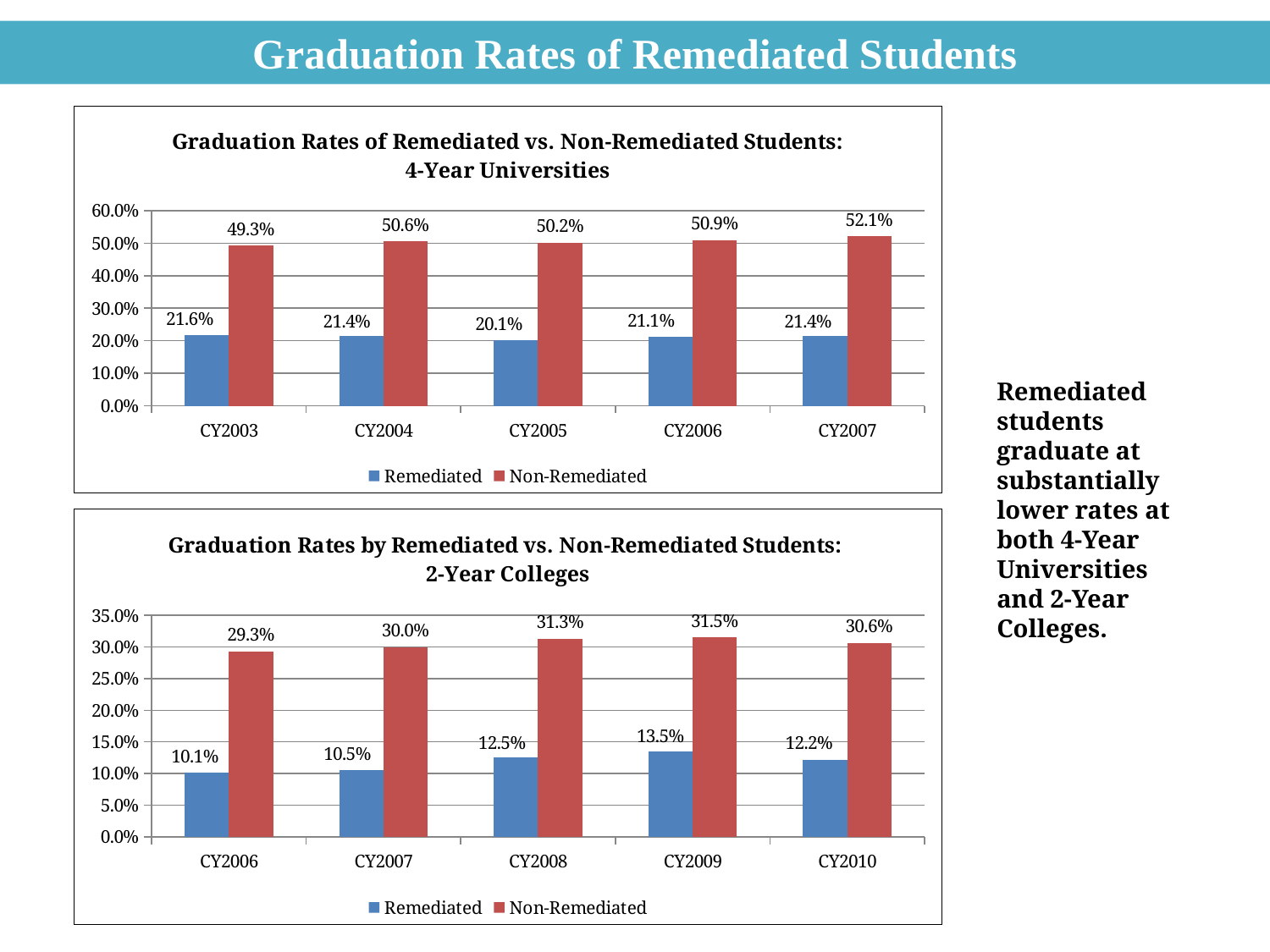
In the 2-Year Colleges chart, which year has the lowest Remediated graduation rate? CY2006 In the 2-Year Colleges chart, is the Remediated graduation rate higher in CY2008 or CY2009? CY2009 What type of chart is the 2-Year Colleges chart? Bar chart In the 2-Year Colleges chart, what is the difference between the Non-Remediated and Remediated graduation rates in CY2010? 18.4% In the 4-Year Universities chart, what is the graduation rate for Non-Remediated students in CY2007? 52.1% In the 4-Year Universities chart, what is the graduation rate for Remediated students in CY2005? 20.1% In the 2-Year Colleges chart, what is the graduation rate for Non-Remediated students in CY2006? 29.3% How many series does the legend of the 2-Year Colleges chart list? 2 In the 2-Year Colleges chart, what is the graduation rate for Remediated students in CY2009? 13.5% In the 4-Year Universities chart, which year has the highest Non-Remediated graduation rate? CY2007 In the 4-Year Universities chart, what is the difference between the Non-Remediated and Remediated graduation rates in CY2003? 27.7% How many years are shown on the x axis of the 4-Year Universities chart? 5